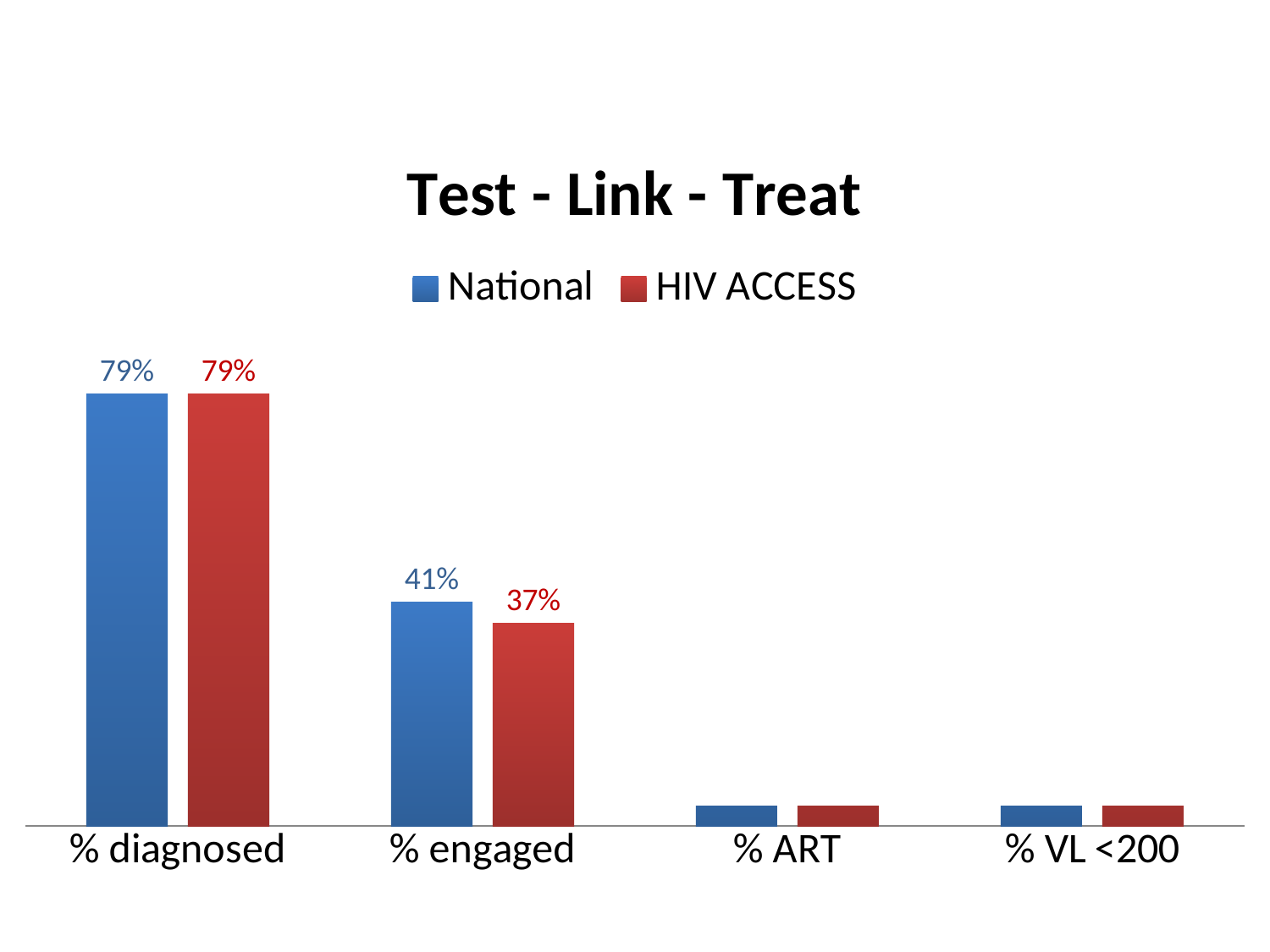
Which series is shown in red? HIV ACCESS What is the HIV ACCESS value for % diagnosed? 79% What is the National value for % engaged? 41% What is the title of the chart? Test - Link - Treat What is the National value for % diagnosed? 79% What is the difference between the National and HIV ACCESS values for % engaged? 4% How many categories are shown on the x axis? 4 What kind of chart is shown on the slide? bar chart For % engaged, which series has the larger value, National or HIV ACCESS? National What is the HIV ACCESS value for % engaged? 37% Which category has the highest National value? % diagnosed How many series does the legend list? 2